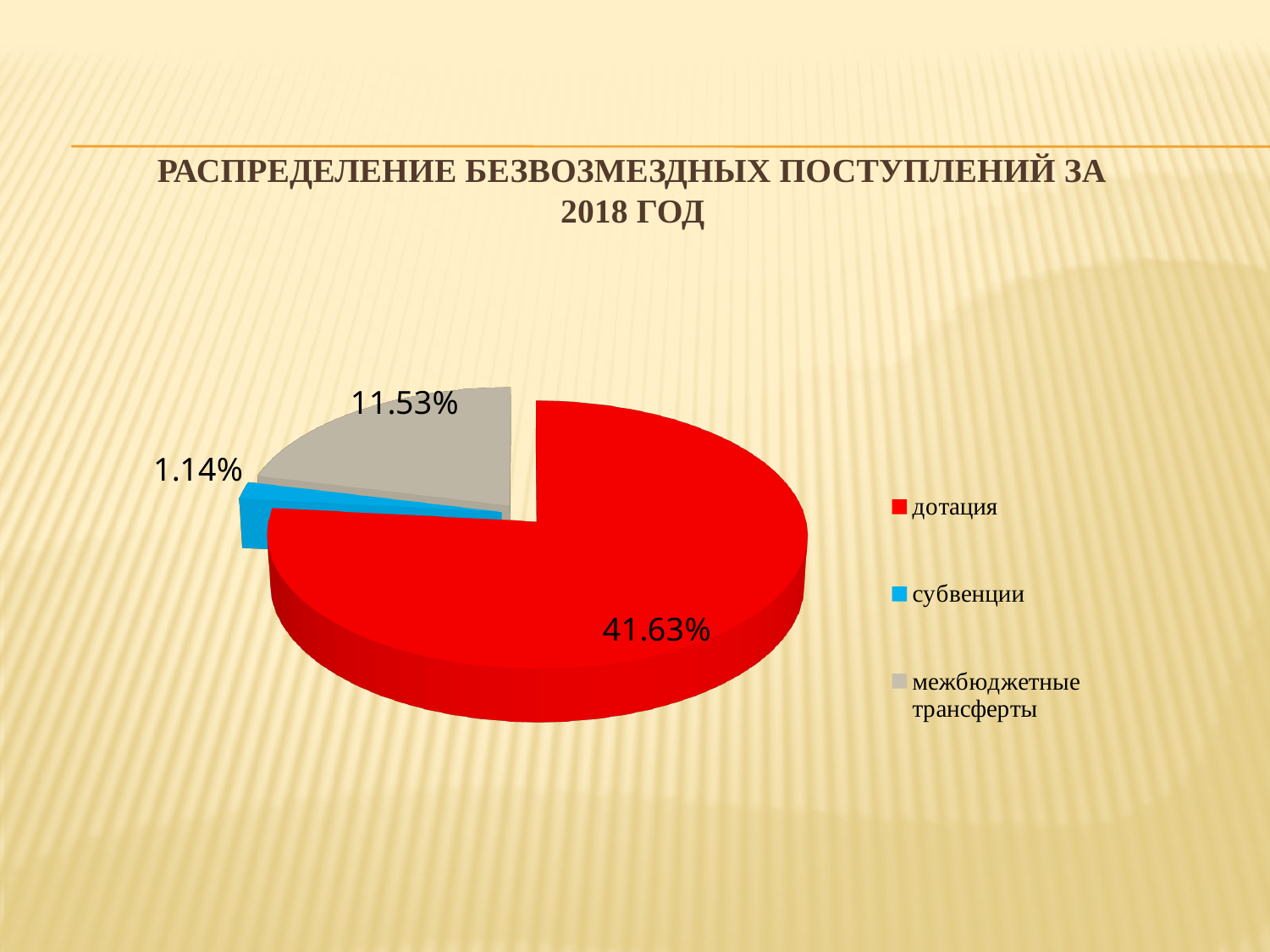
Which category has the smallest slice of the pie? субвенции What is the value shown for межбюджетные трансферты? 11.53% What is the difference between the values for межбюджетные трансферты and субвенции? 10.39% Which is larger, the value for межбюджетные трансферты or the value for субвенции? межбюджетные трансферты What is the title of the chart? РАСПРЕДЕЛЕНИЕ БЕЗВОЗМЕЗДНЫХ ПОСТУПЛЕНИЙ ЗА 2018 ГОД What type of chart is shown on the slide? Pie chart Which category has the largest slice of the pie? дотация How many categories does the pie chart show? 3 What colour is the slice for субвенции? Blue What is the difference between the values for дотация and межбюджетные трансферты? 30.10% What is the value shown for субвенции? 1.14% What is the value shown for дотация? 41.63%